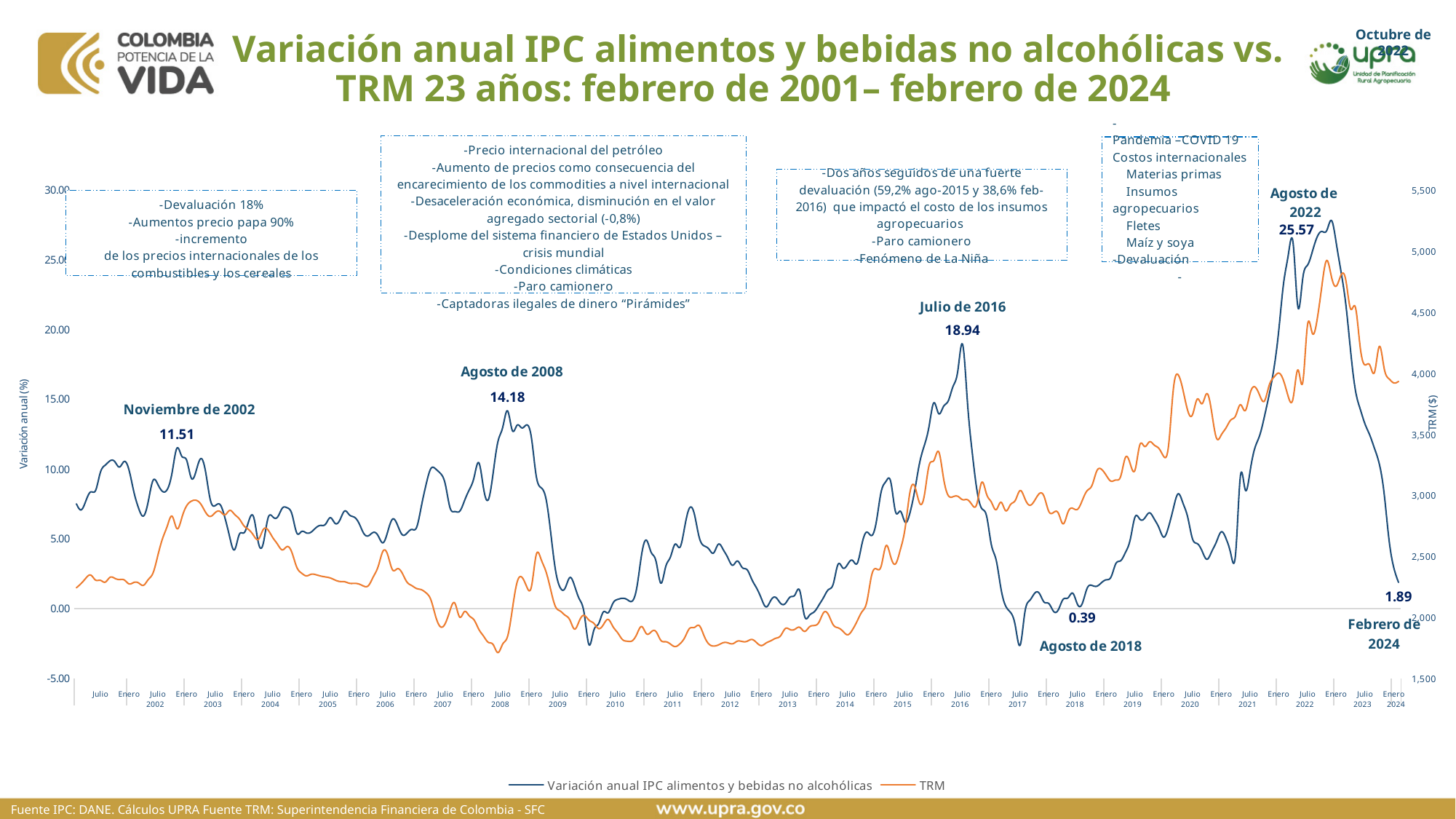
Which labelled point has the lowest annual CPI variation value? Agosto de 2018 What kind of chart is shown on the slide? line chart What is the labelled value of the annual CPI variation in Noviembre de 2002? 11.51 Which labelled point has the highest annual CPI variation value? Agosto de 2022 What is the labelled value of the annual CPI variation in Agosto de 2008? 14.18 What is the labelled value of the annual CPI variation in Julio de 2016? 18.94 Which labelled value is larger: Agosto de 2008 or Noviembre de 2002? Agosto de 2008 What is the labelled value of the annual CPI variation in Febrero de 2024? 1.89 What is the difference between the labelled values for Agosto de 2022 and Julio de 2016? 6.63 What is the labelled value of the annual food and non-alcoholic beverages CPI variation in Agosto de 2022? 25.57 What is the label of the right-hand vertical axis? TRM($) How many series does the legend list? 2